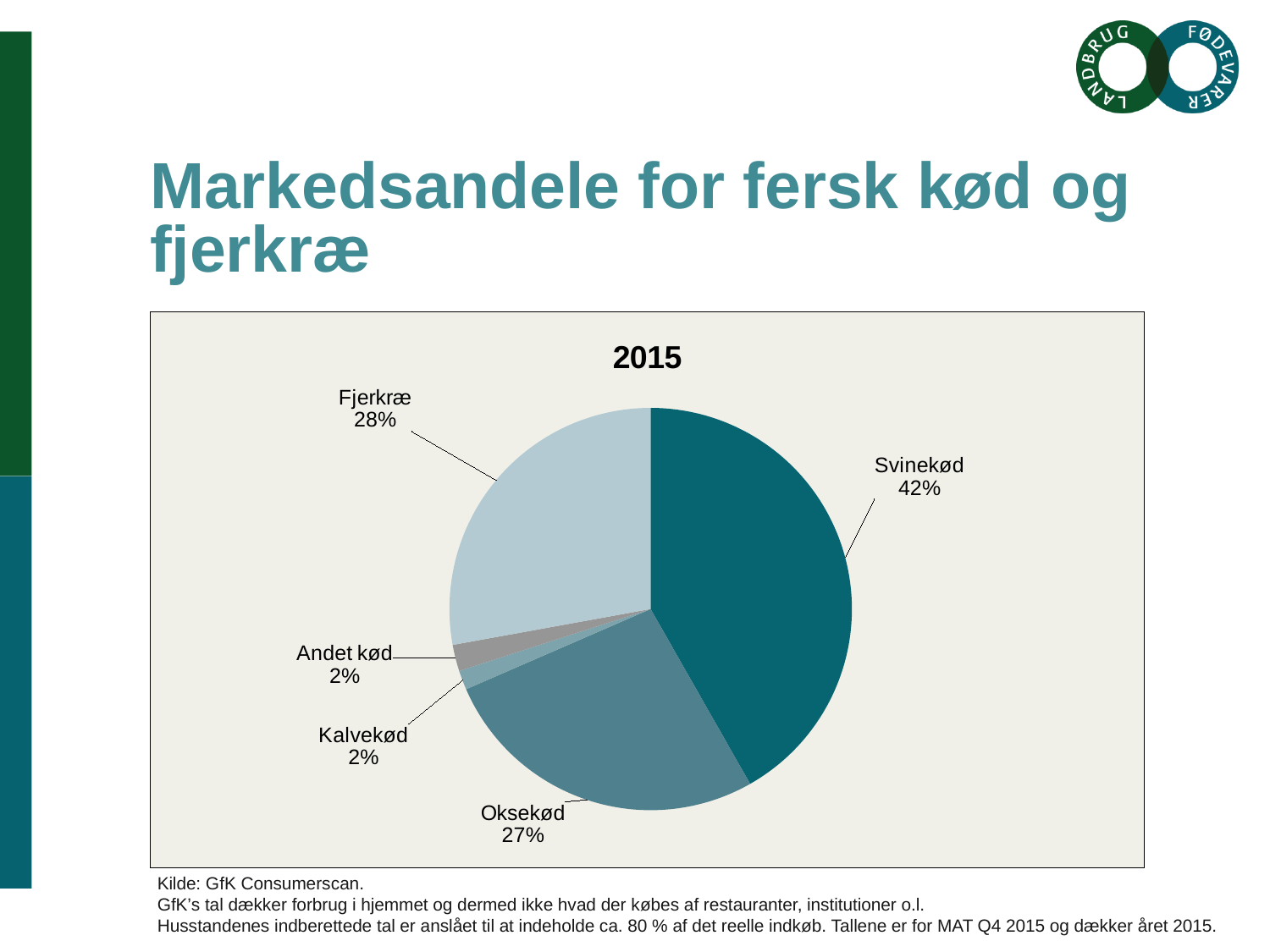
What share does Kalvekød have in the pie chart? 2% What type of chart is shown on the slide? Pie chart How many categories are shown in the pie chart? 5 What share does Svinekød have in the pie chart? 42% Which is larger, the share for Fjerkræ or the share for Oksekød? Fjerkræ What is the difference in percentage points between Svinekød and Oksekød? 15 percentage points What share does Oksekød have in the pie chart? 27% What share does Fjerkræ have in the pie chart? 28% What is the difference in percentage points between Fjerkræ and Andet kød? 26 percentage points What is the chart's title? 2015 What is the combined share of Svinekød and Fjerkræ? 70% Which category has the largest share of the pie? Svinekød